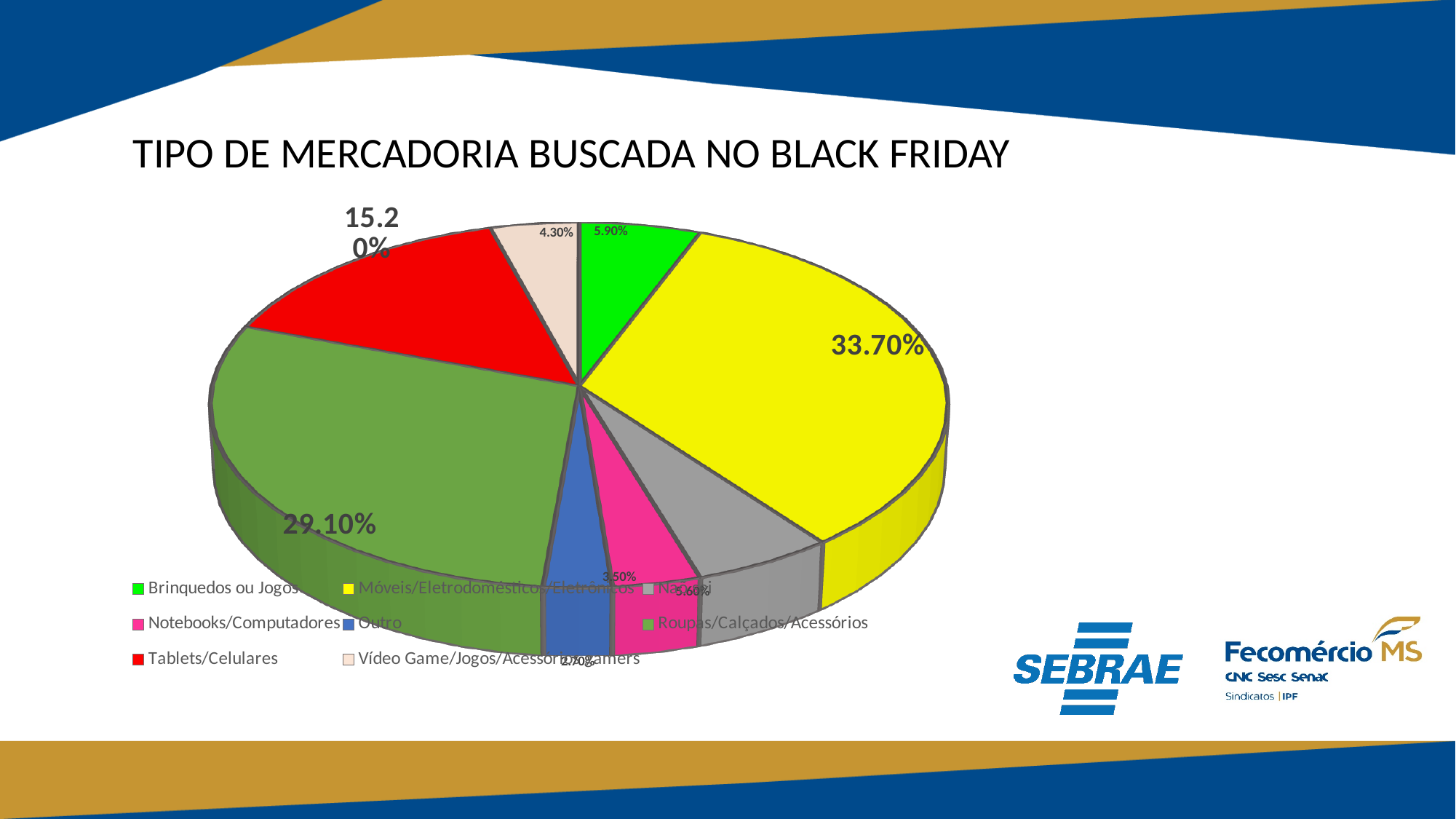
What type of chart is shown on the slide? pie chart What colour is the slice for Tablets/Celulares? red What is the value for Brinquedos ou Jogos? 5.90% What is the value for Vídeo Game/Jogos/Acessórios Gamers? 4.30% How many categories does the pie chart have? 8 Which is larger, the value for Brinquedos ou Jogos or the value for Vídeo Game/Jogos/Acessórios Gamers? Brinquedos ou Jogos What is the value for Roupas/Calçados/Acessórios? 29.10% What is the difference between the values for Móveis/Eletrodomésticos/Eletrônicos and Roupas/Calçados/Acessórios? 4.60% What is the value for Tablets/Celulares? 15.20% What is the title of the chart? TIPO DE MERCADORIA BUSCADA NO BLACK FRIDAY Which category has the largest slice of the pie? Móveis/Eletrodomésticos/Eletrônicos What share of the pie does Móveis/Eletrodomésticos/Eletrônicos represent? 33.70%